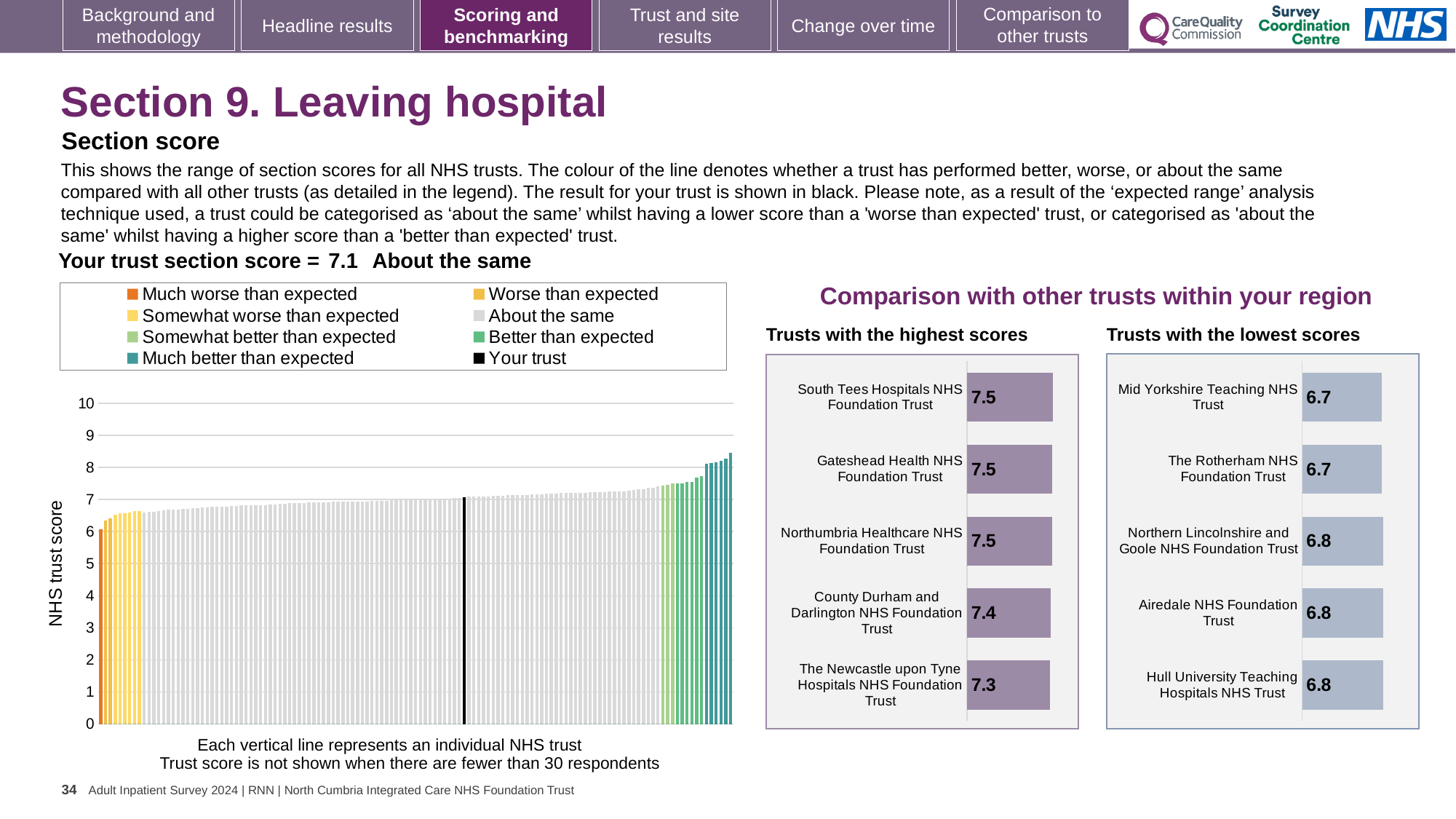
In the 'Trusts with the lowest scores' chart, what is the difference between the scores of Hull University Teaching Hospitals NHS Trust and The Rotherham NHS Foundation Trust? 0.1 In the 'Trusts with the highest scores' chart, what is the score for South Tees Hospitals NHS Foundation Trust? 7.5 In the large chart on the left showing NHS trust scores, do the bar values rise or fall from left to right? rise In the large chart on the left showing NHS trust scores, is the value of the tallest bar greater or less than 8? greater In the 'Trusts with the highest scores' chart, which has the higher score: County Durham and Darlington NHS Foundation Trust or The Newcastle upon Tyne Hospitals NHS Foundation Trust? County Durham and Darlington NHS Foundation Trust How many entries does the legend of the large chart on the left list? 8 In the 'Trusts with the lowest scores' chart, what is the score for Airedale NHS Foundation Trust? 6.8 In the 'Trusts with the highest scores' chart, what is the difference between the scores of South Tees Hospitals NHS Foundation Trust and The Newcastle upon Tyne Hospitals NHS Foundation Trust? 0.2 In the 'Trusts with the highest scores' chart, what is the score for The Newcastle upon Tyne Hospitals NHS Foundation Trust? 7.3 In the 'Trusts with the highest scores' chart, which trust has the lowest score? The Newcastle upon Tyne Hospitals NHS Foundation Trust In the 'Trusts with the lowest scores' chart, what is the score for Mid Yorkshire Teaching NHS Trust? 6.7 How many trusts are shown in the 'Trusts with the lowest scores' chart? 5